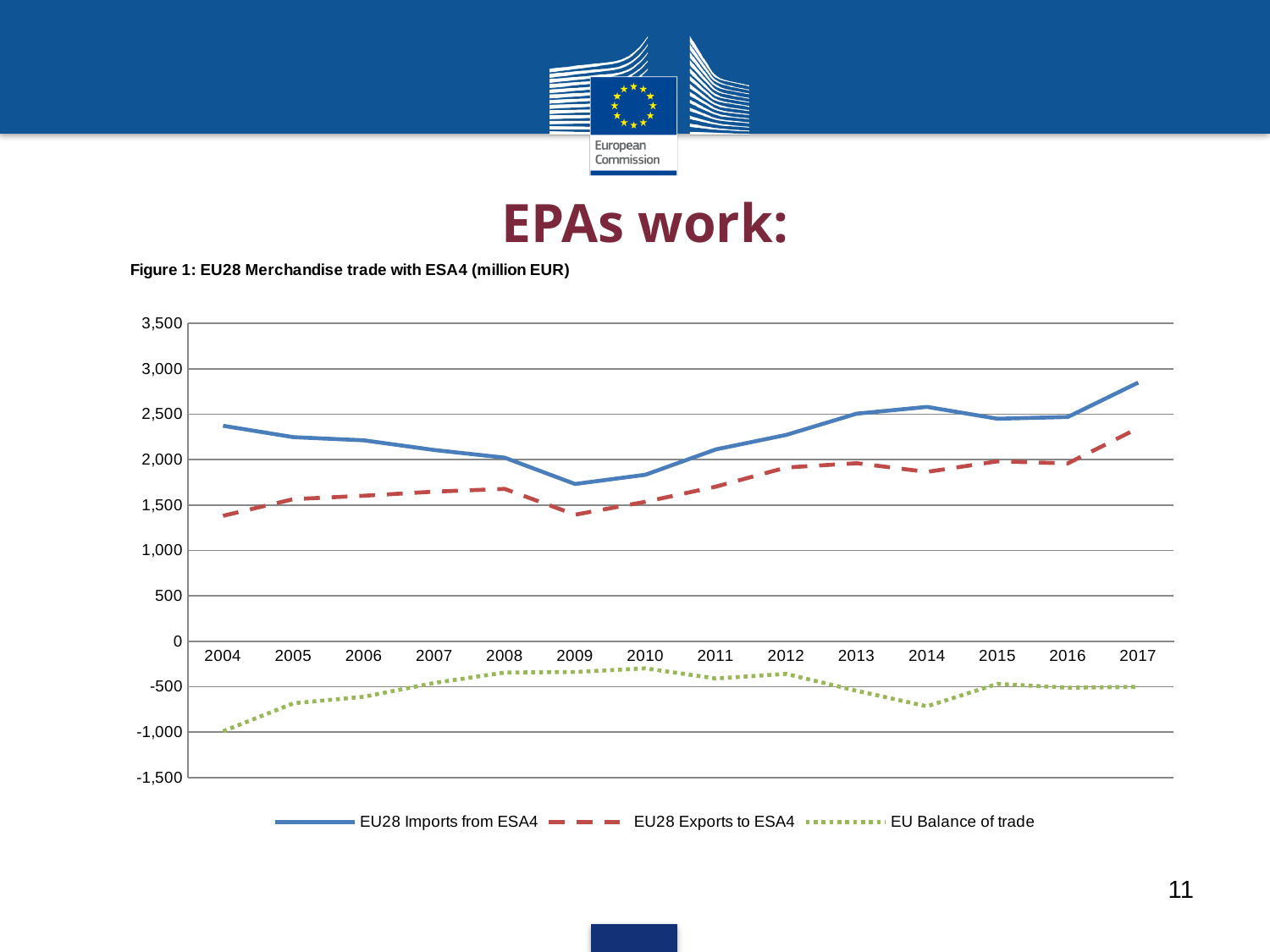
Which is larger in 2017, EU28 Imports from ESA4 or EU28 Exports to ESA4? EU28 Imports from ESA4 How many series does the legend list? 3 What is the title of the figure? Figure 1: EU28 Merchandise trade with ESA4 (million EUR) In which year is EU28 Exports to ESA4 highest? 2017 What kind of chart is shown on the slide? Line chart In which year is EU28 Imports from ESA4 lowest? 2009 In which year is EU28 Imports from ESA4 highest? 2017 Is the value for EU28 Exports to ESA4 in 2004 greater or less than 1,500? less Is the value for EU28 Imports from ESA4 in 2017 greater or less than 2,500? greater In which year is the EU Balance of trade lowest? 2004 Do the values for EU28 Imports from ESA4 rise or fall from 2004 to 2009? Fall How many years are plotted along the x axis? 14